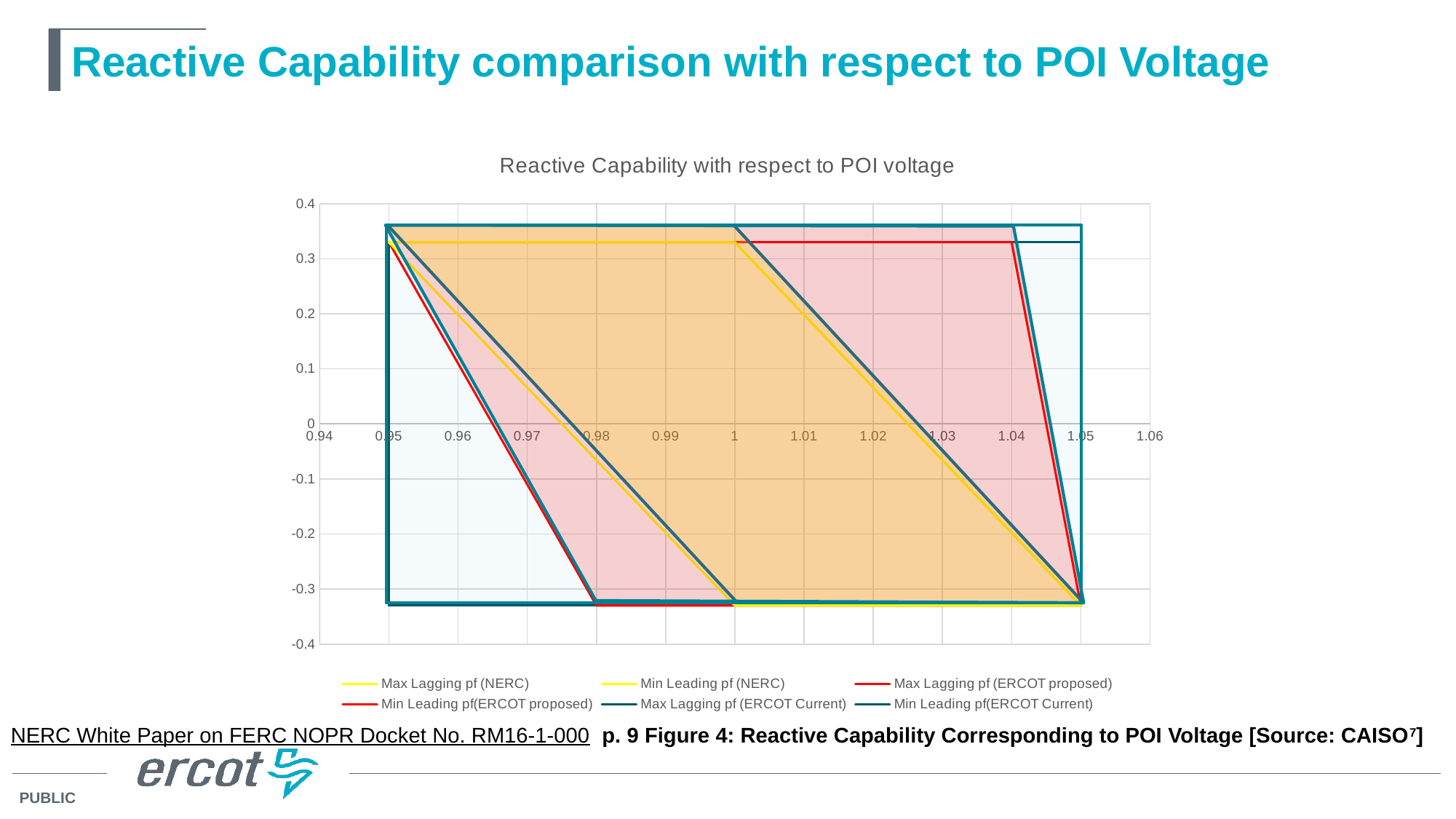
At a POI voltage of 1.02, is the value of Max Lagging pf (ERCOT proposed) greater or less than 0.3? greater Does the Min Leading pf (NERC) series rise or fall as POI voltage goes from 1 to 1.05? Neither; it stays flat At a POI voltage of 0.96, is the value of Max Lagging pf (NERC) greater or less than 0.3? greater What kind of chart is shown on the slide? line chart What is the title of the chart? Reactive Capability with respect to POI voltage How many series does the legend list? 6 At a POI voltage of 1, is the value of Min Leading pf(ERCOT Current) greater or less than -0.3? less What colour are the ERCOT Current series drawn in? teal